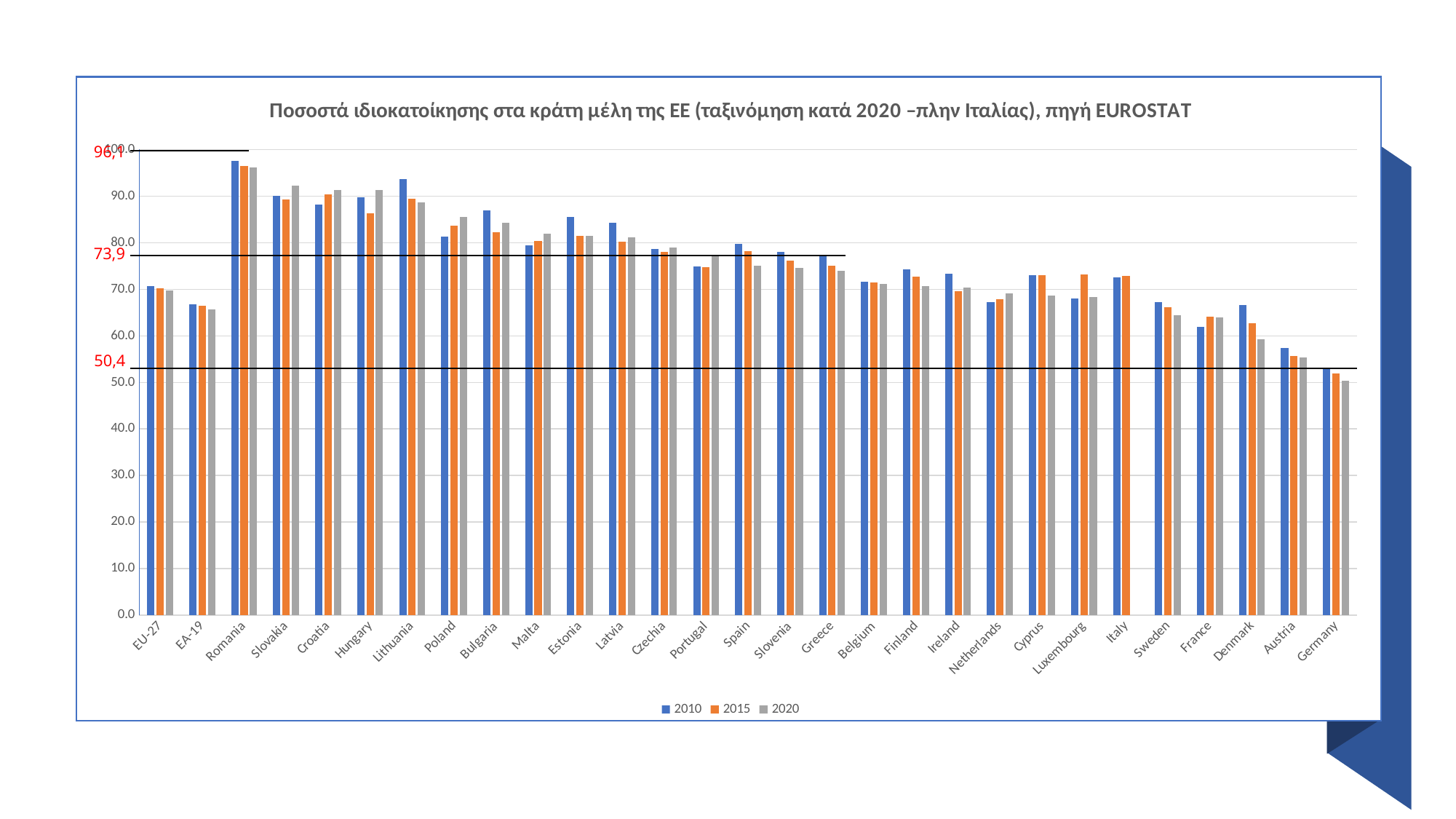
What kind of chart is shown on the slide? bar chart Which country on the chart has no bar for 2020? Italy How many categories are shown on the x axis? 29 Do the 2020 values generally rise or fall moving from Romania to Germany along the x axis? fall Which country has the highest value for 2020? Romania Which years are listed in the legend? 2010, 2015, 2020 Which is larger, the 2010 value for Romania or the 2010 value for Germany? Romania Which country has the lowest value for 2020? Germany Is the value for Romania in 2010 greater or less than 90? greater How many series does the legend list? 3 Is the value for Germany in 2020 greater or less than 60? less Is the value for Netherlands in 2010 greater or less than 70? less